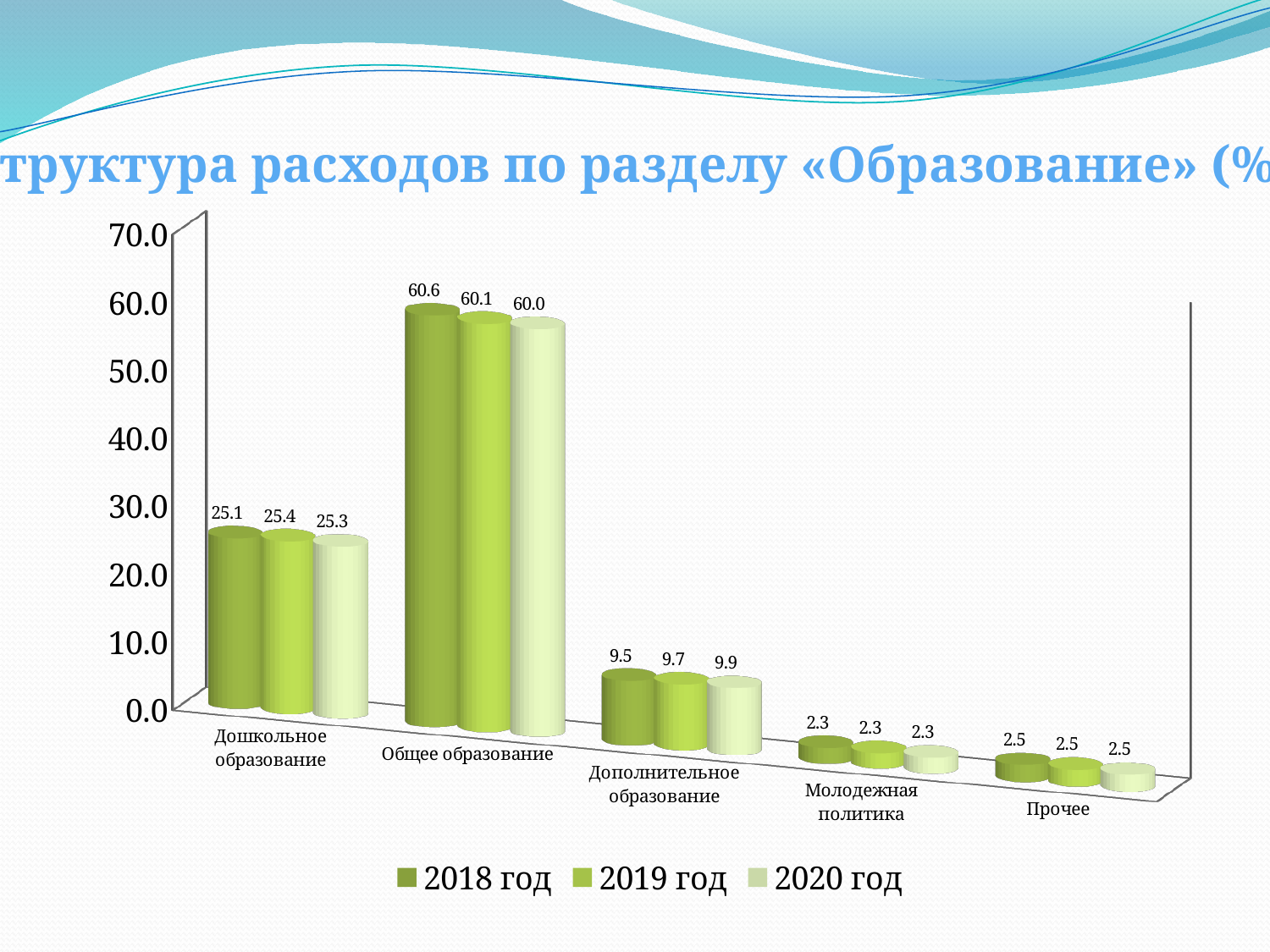
How many series does the legend list? 3 What is the value for Дошкольное образование in 2020 год? 25.3 Which is larger: the 2019 год value for Дошкольное образование or the 2019 год value for Дополнительное образование? Дошкольное образование How many categories are shown on the x axis? 5 What is the value for Дополнительное образование in 2019 год? 9.7 What is the difference between the 2018 год and 2020 год values for Общее образование? 0.6 Which category has the lowest value in 2020 год? Молодежная политика What kind of chart is shown on the slide? Bar chart What is the value for Общее образование in 2018 год? 60.6 Which category has the highest value in 2019 год? Общее образование What is the value for Молодежная политика in 2018 год? 2.3 What is the value for Прочее in 2020 год? 2.5